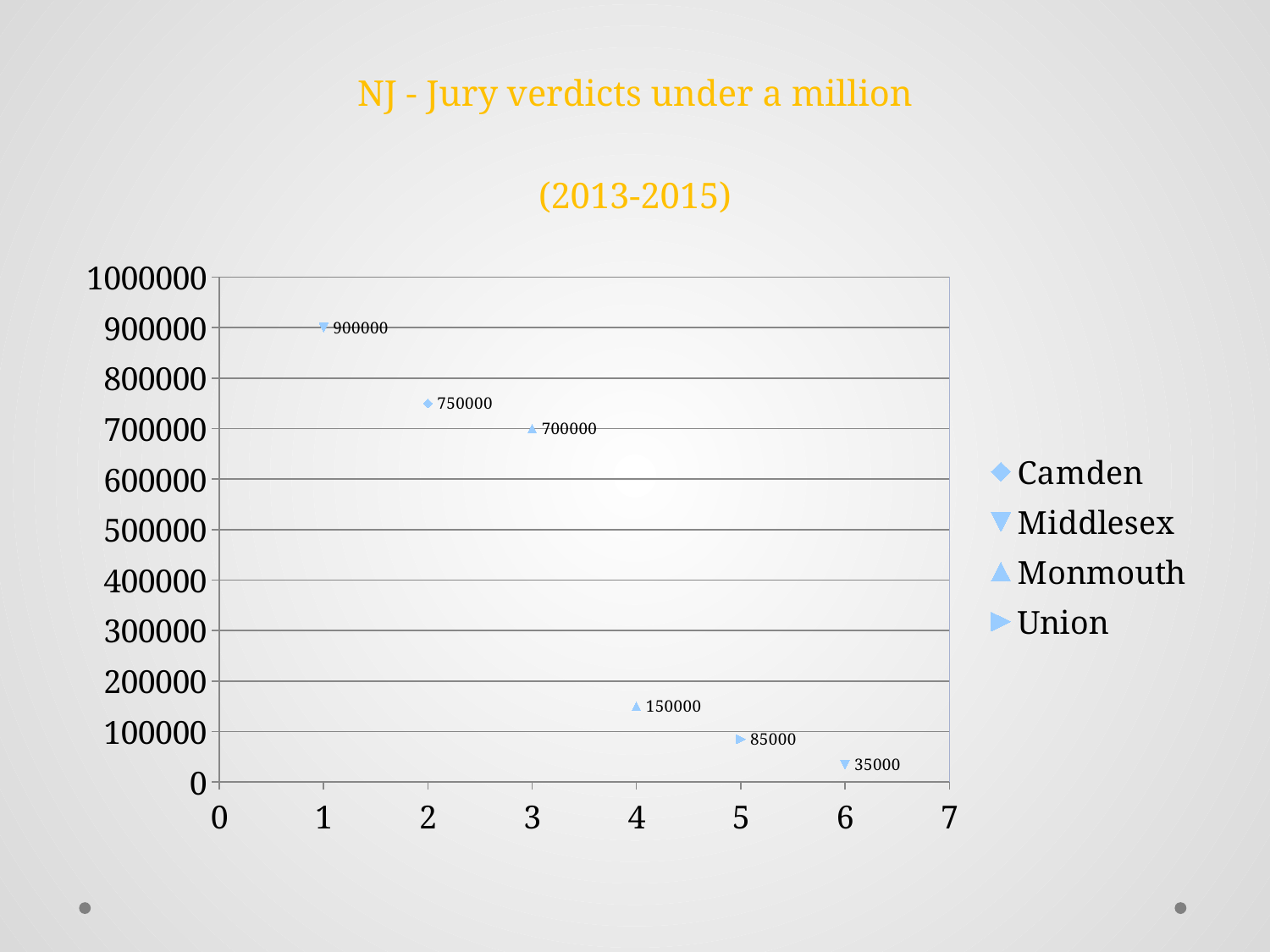
What is the value of the Union data point? 85000 What is the value of the data point at x = 1? 900000 What is the difference between the data point at x = 3 and the data point at x = 4? 550000 What type of chart is shown on the slide? scatter chart What is the lowest value plotted on the chart? 35000 How many data points are plotted on the chart? 6 What is the highest value plotted on the chart? 900000 What is the title of the chart? NJ - Jury verdicts under a million (2013-2015) What is the value of the data point at x = 6? 35000 What is the value of the Camden data point? 750000 How many series does the legend list? 4 What is the value of the data point at x = 2? 750000